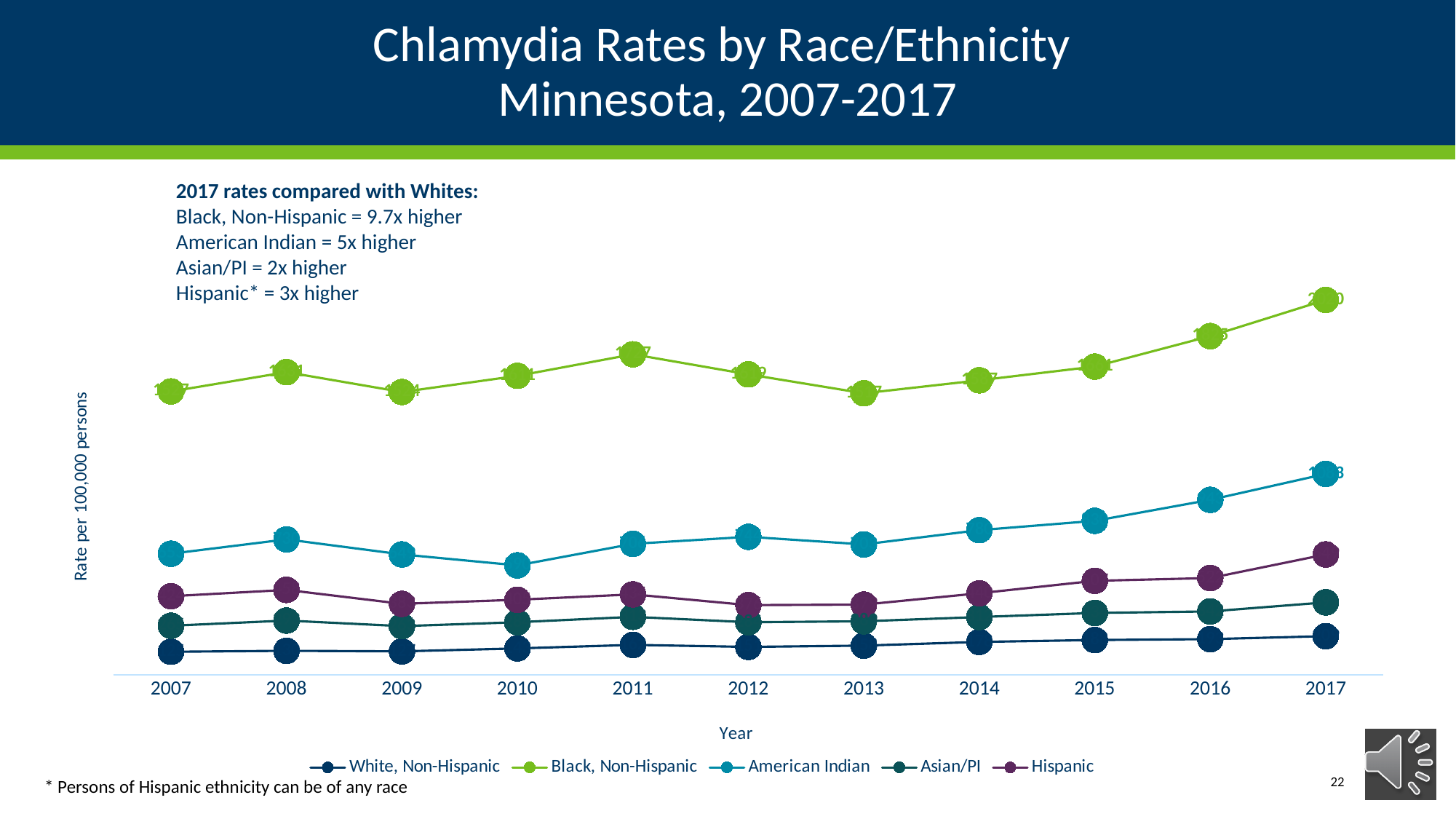
In 2007, which is higher: the rate for Asian/PI or the rate for Hispanic? Hispanic How many years are plotted along the x axis? 11 Which race/ethnicity group has the lowest chlamydia rate in 2017? White, Non-Hispanic Does the American Indian rate rise or fall between 2010 and 2017? rise What is the label on the y axis? Rate per 100,000 persons Does the Black, Non-Hispanic rate rise or fall between 2013 and 2017? rise Which series is plotted in light green? Black, Non-Hispanic Which race/ethnicity group has the highest chlamydia rate in 2017? Black, Non-Hispanic How many series does the legend list? 5 Which year is the first on the x axis? 2007 In 2017, which is higher: the rate for American Indian or the rate for Hispanic? American Indian What kind of chart is shown on the slide? line chart